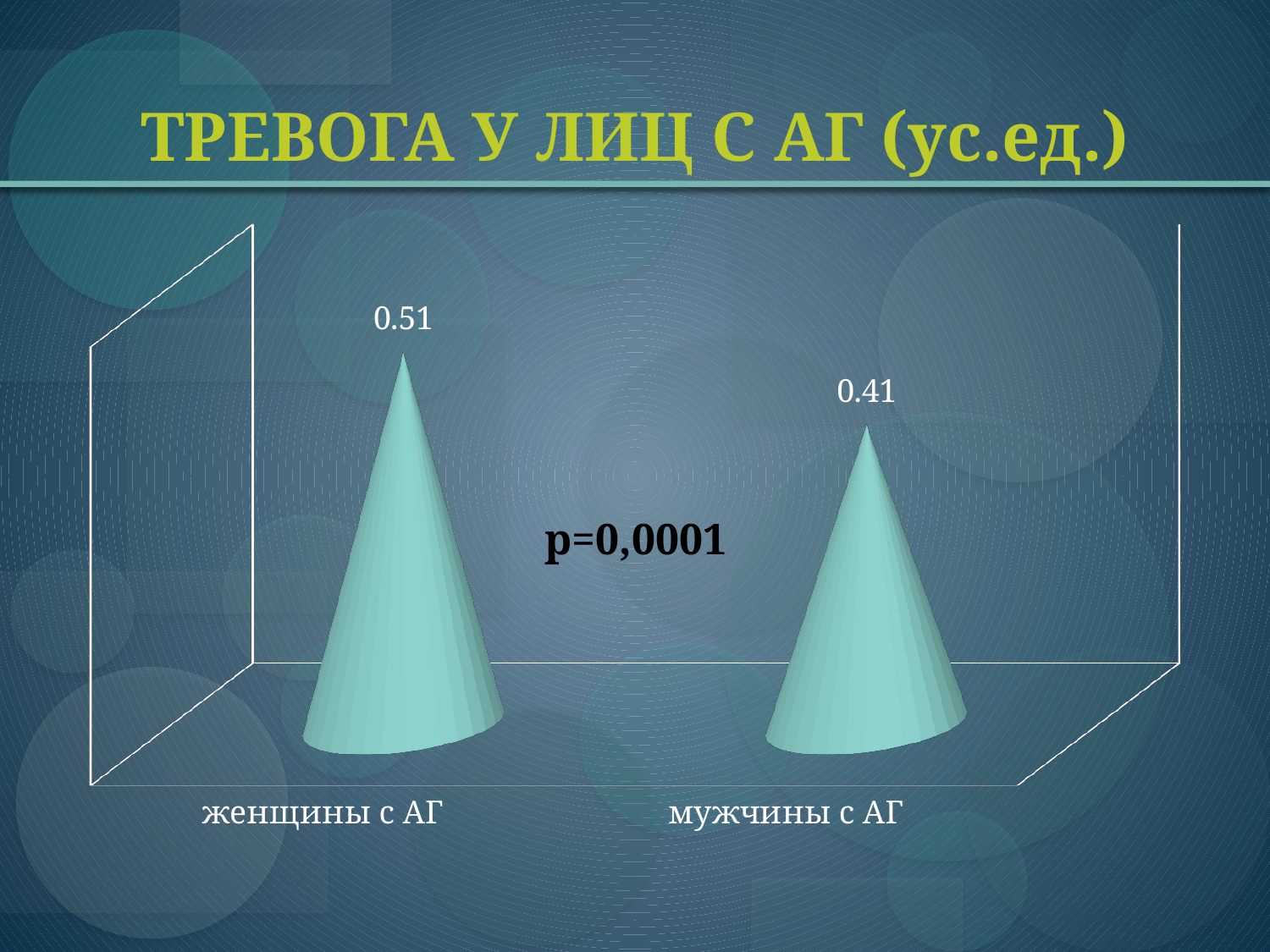
What p-value is printed on the chart? p=0,0001 What is the value for женщины с АГ? 0.51 Which category has the lowest value? мужчины с АГ How many categories are shown in the chart? 2 What is the difference between the values for женщины с АГ and мужчины с АГ? 0.10 What is the value for мужчины с АГ? 0.41 Do the values rise or fall from left to right along the x axis? fall What is the title of the chart? ТРЕВОГА У ЛИЦ С АГ (ус.ед.) Which category has the highest value? женщины с АГ What kind of chart is shown on the slide? bar chart Which is larger, the value for женщины с АГ or for мужчины с АГ? женщины с АГ